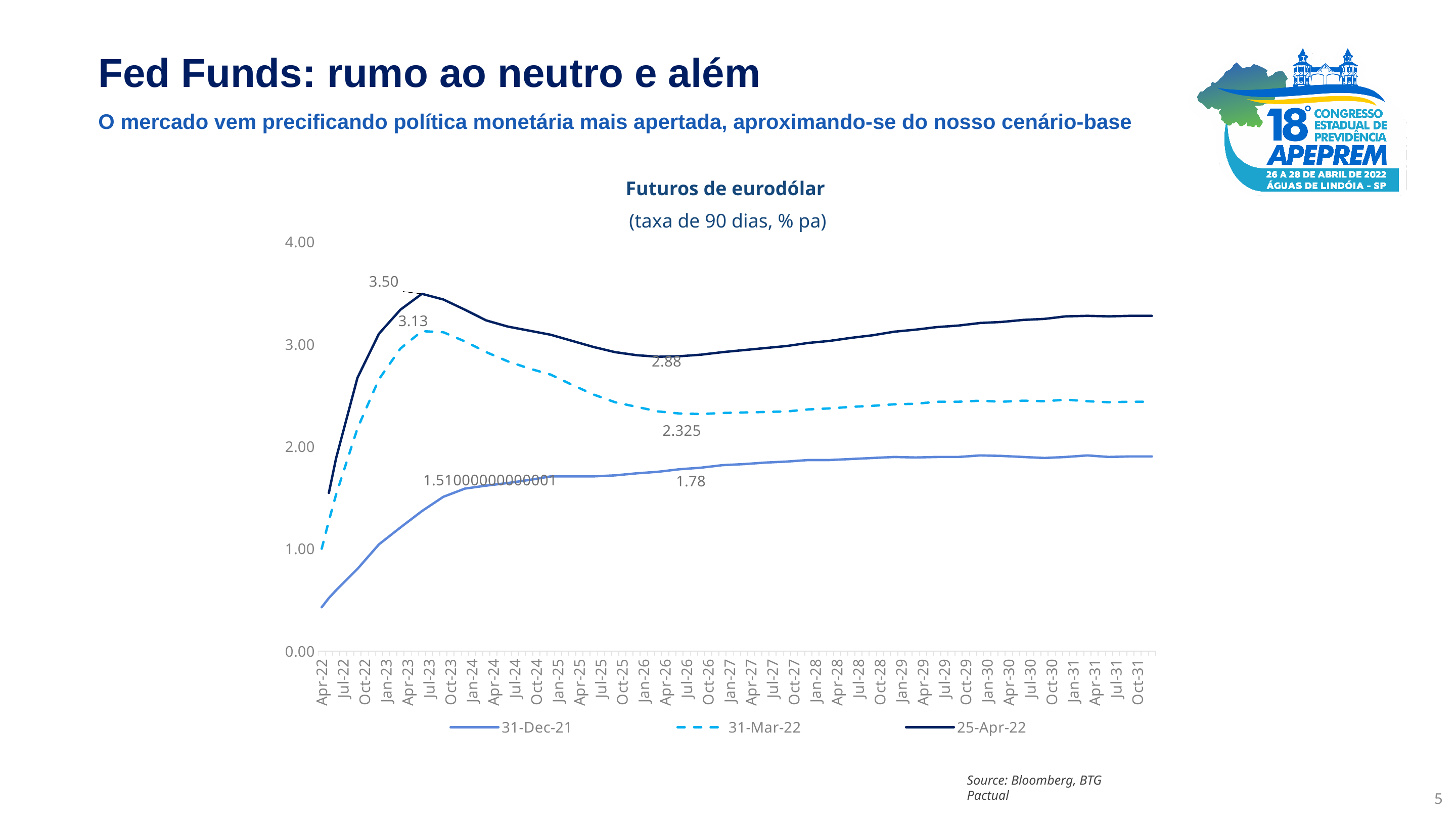
What is the peak value labelled on the 31-Mar-22 series? 3.13 What is the peak value labelled on the 25-Apr-22 series? 3.50 Which series has the lowest values across the whole chart? 31-Dec-21 What is the difference between the labelled peaks of the 25-Apr-22 series (3.50) and the 31-Mar-22 series (3.13)? 0.37 Is the value of the 25-Apr-22 series at Oct-31 greater or less than 3.00? greater How many series does the legend of the 'Futuros de eurodólar' chart list? 3 What is the trough value labelled on the 25-Apr-22 series around Apr-26? 2.88 What kind of chart is shown on the slide? line chart What are the three series named in the legend of the chart? 31-Dec-21, 31-Mar-22, 25-Apr-22 Which series reaches the highest value on the chart? 25-Apr-22 Is the value of the 31-Dec-21 series at Apr-22 greater or less than 1.00? less What is the trough value labelled on the 31-Mar-22 series around Jul-26? 2.325